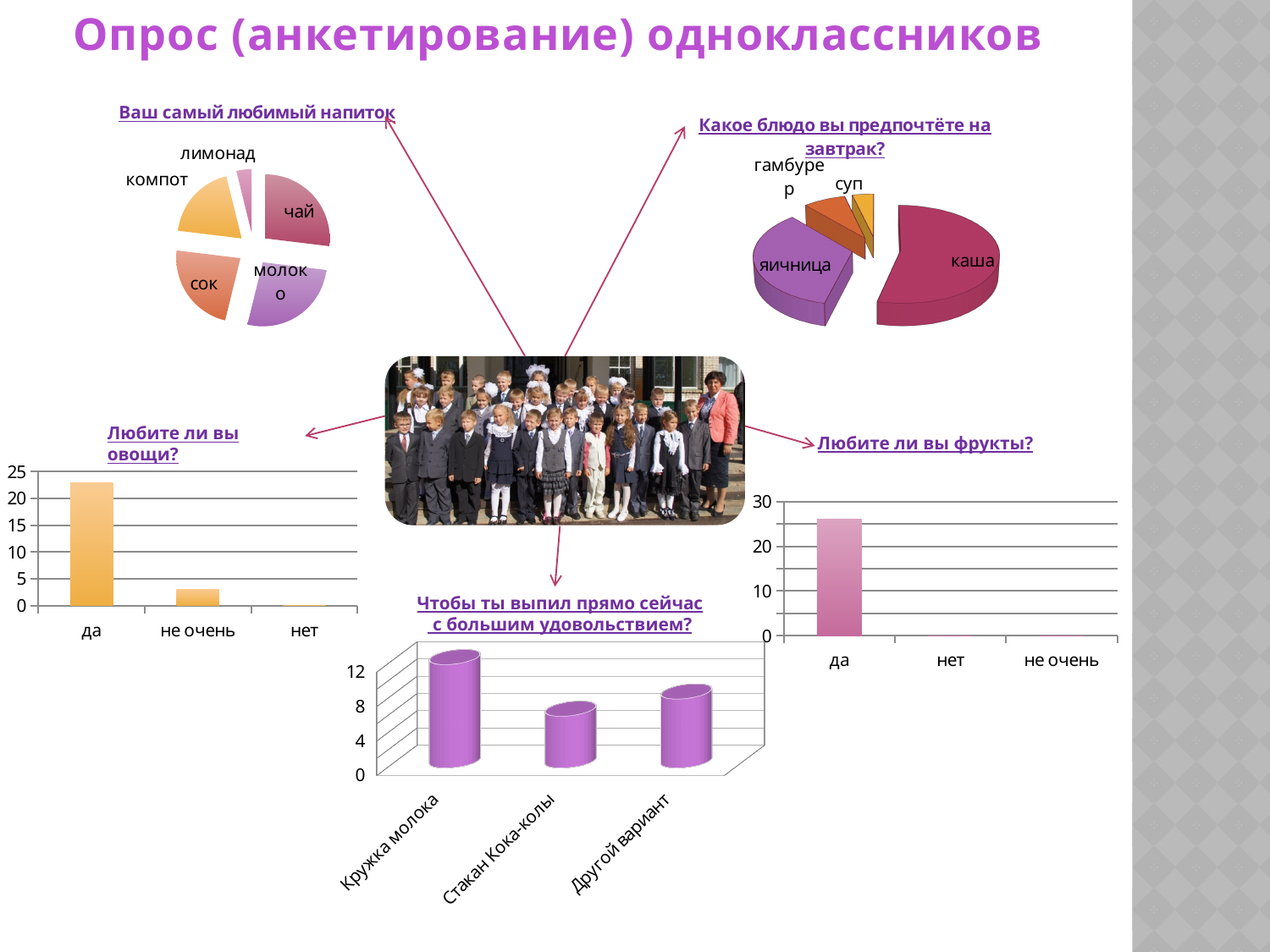
On the chart titled 'Любите ли вы фрукты?', is the value for 'да' greater or less than 20? greater On the chart titled 'Ваш самый любимый напиток', how many categories does the pie show? 5 On the chart titled 'Чтобы ты выпил прямо сейчас с большим удовольствием?', which category has the lowest value? Стакан Кока-колы On the chart titled 'Любите ли вы овощи?', which category has the highest value? да On the chart titled 'Чтобы ты выпил прямо сейчас с большим удовольствием?', which category has the highest value? Кружка молока On the chart titled 'Ваш самый любимый напиток', which category has the smallest slice? лимонад On the chart titled 'Любите ли вы овощи?', which is larger, the value for 'да' or the value for 'не очень'? да On the chart titled 'Какое блюдо вы предпочтёте на завтрак?', which category has the largest slice? каша On the chart titled 'Какое блюдо вы предпочтёте на завтрак?', how many categories does the pie show? 4 On the chart titled 'Любите ли вы фрукты?', how many categories are shown on the x axis? 3 On the chart titled 'Любите ли вы овощи?', is the value for 'да' greater or less than 20? greater What kind of chart is the one titled 'Чтобы ты выпил прямо сейчас с большим удовольствием?'? bar chart